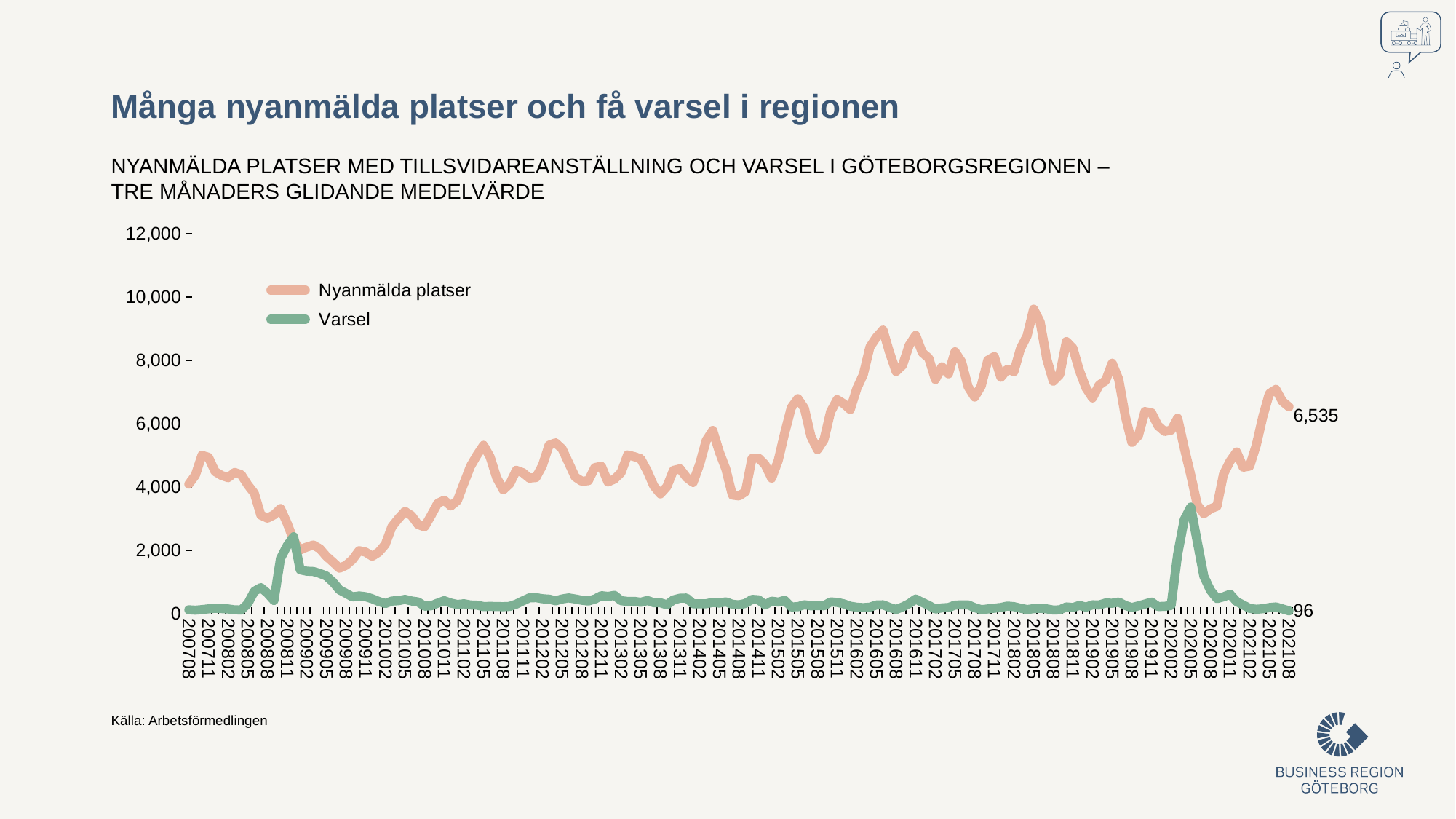
Is the value of Nyanmälda platser around 200908 greater or less than 4,000? less At the end of the series, which line has the larger value, Nyanmälda platser or Varsel? Nyanmälda platser Around which x-axis label does the Varsel line reach its highest point? 202005 What is the final labelled value of the Varsel line? 96 How many series does the legend list? 2 Is the value of Nyanmälda platser at its peak around 201805 greater or less than 8,000? greater What is the difference between the final labelled values of Nyanmälda platser and Varsel? 6,439 What kind of chart is shown on the slide? line chart What is the final labelled value of the Nyanmälda platser line? 6,535 Is the value of Varsel at its peak around 202005 greater or less than 2,000? greater What colour is the Varsel line in the legend? green Does the Nyanmälda platser line rise or fall between 201805 and 202005? fall